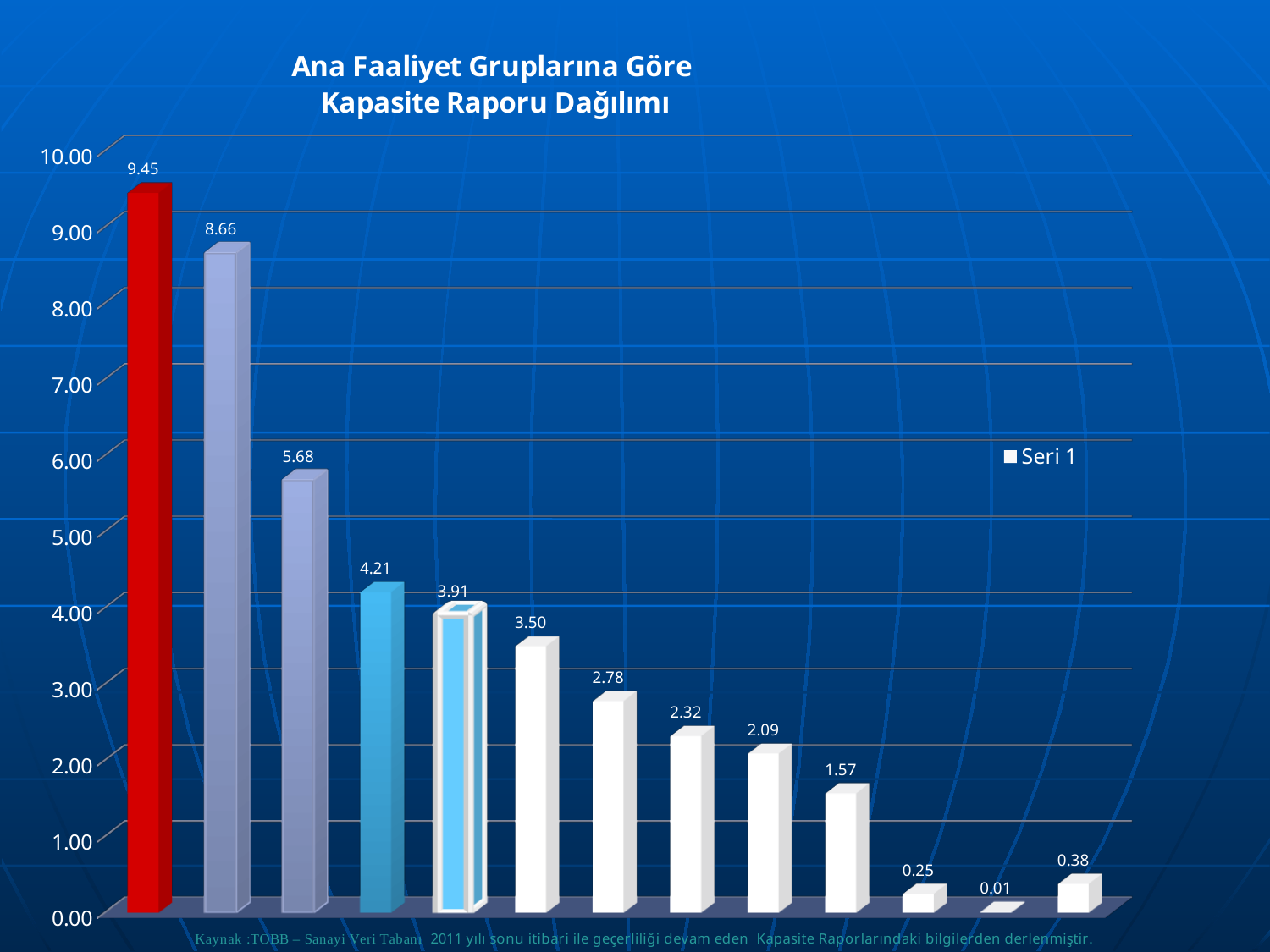
What is the name of the series shown in the legend? Seri 1 Is the value of the third bar from the left greater or less than 5.00? greater How many bars are plotted in the chart? 13 Do the bar values generally rise or fall from left to right across the chart? fall What is the highest value shown in the chart? 9.45 What is the difference between the first bar (9.45) and the second bar (8.66)? 0.79 What kind of chart is shown on the slide? bar chart What is the lowest value shown in the chart? 0.01 What is the value of the rightmost bar? 0.38 How many series does the legend list? 1 What is the value of the red bar? 9.45 What is the title of the chart? Ana Faaliyet Gruplarına Göre Kapasite Raporu Dağılımı